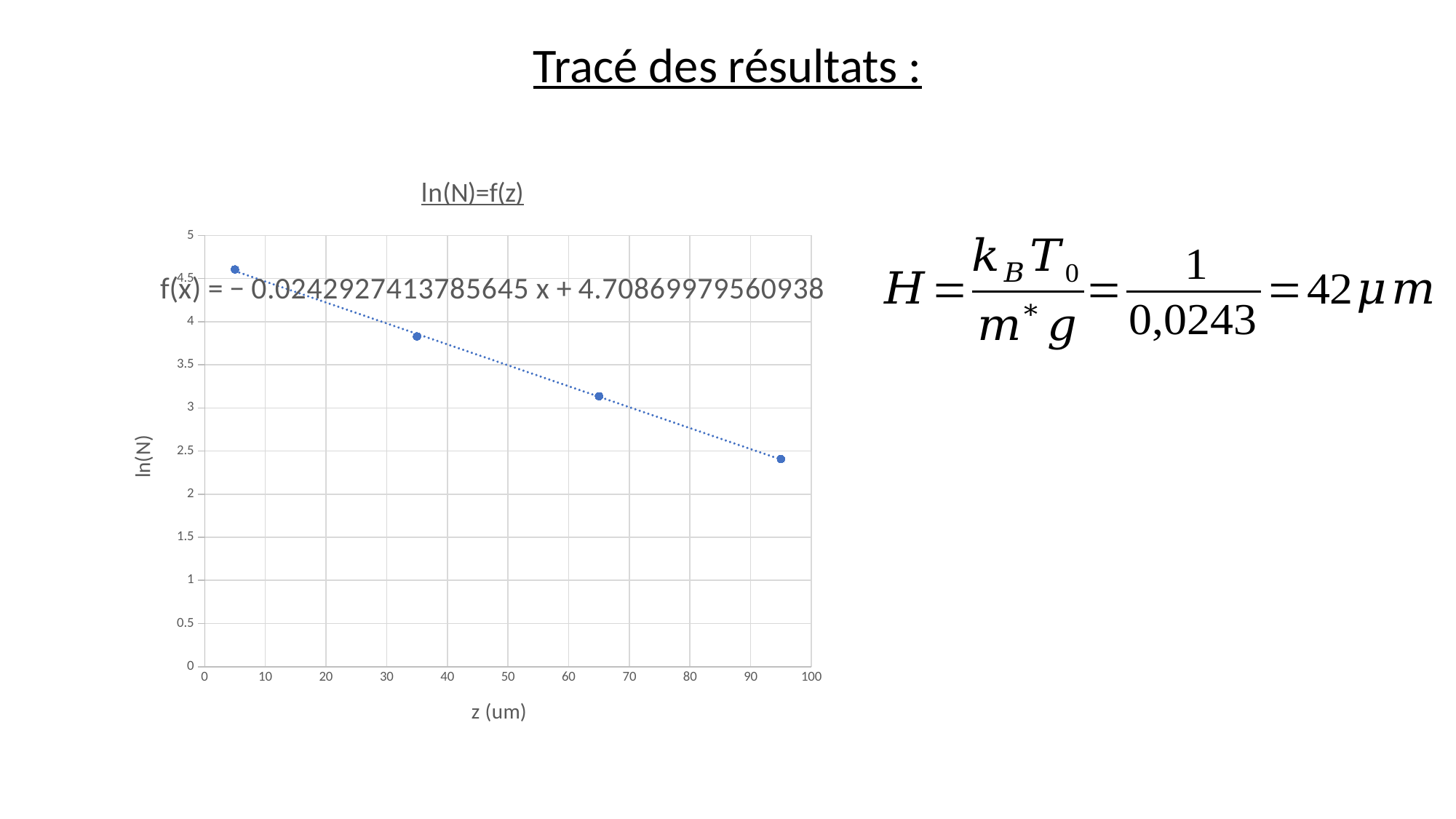
What is the title of the chart? ln(N)=f(z) Is the ln(N) value of the third data point (near z = 65) greater or less than 3.5? less What is the label of the x axis of the chart? z (um) What is the slope of the trendline equation shown on the chart? − 0.0242927413785645 Do the ln(N) values rise or fall as z increases along the x axis? fall How many data points are plotted in the chart? 4 What kind of chart is shown on the slide? scatter chart Is the ln(N) value of the leftmost data point (near z = 5) greater or less than 4? greater Which data point has the highest ln(N) value: the leftmost or the rightmost? the leftmost Is the ln(N) value of the second data point (near z = 35) greater or less than 3.5? greater What is the intercept of the trendline equation shown on the chart? 4.70869979560938